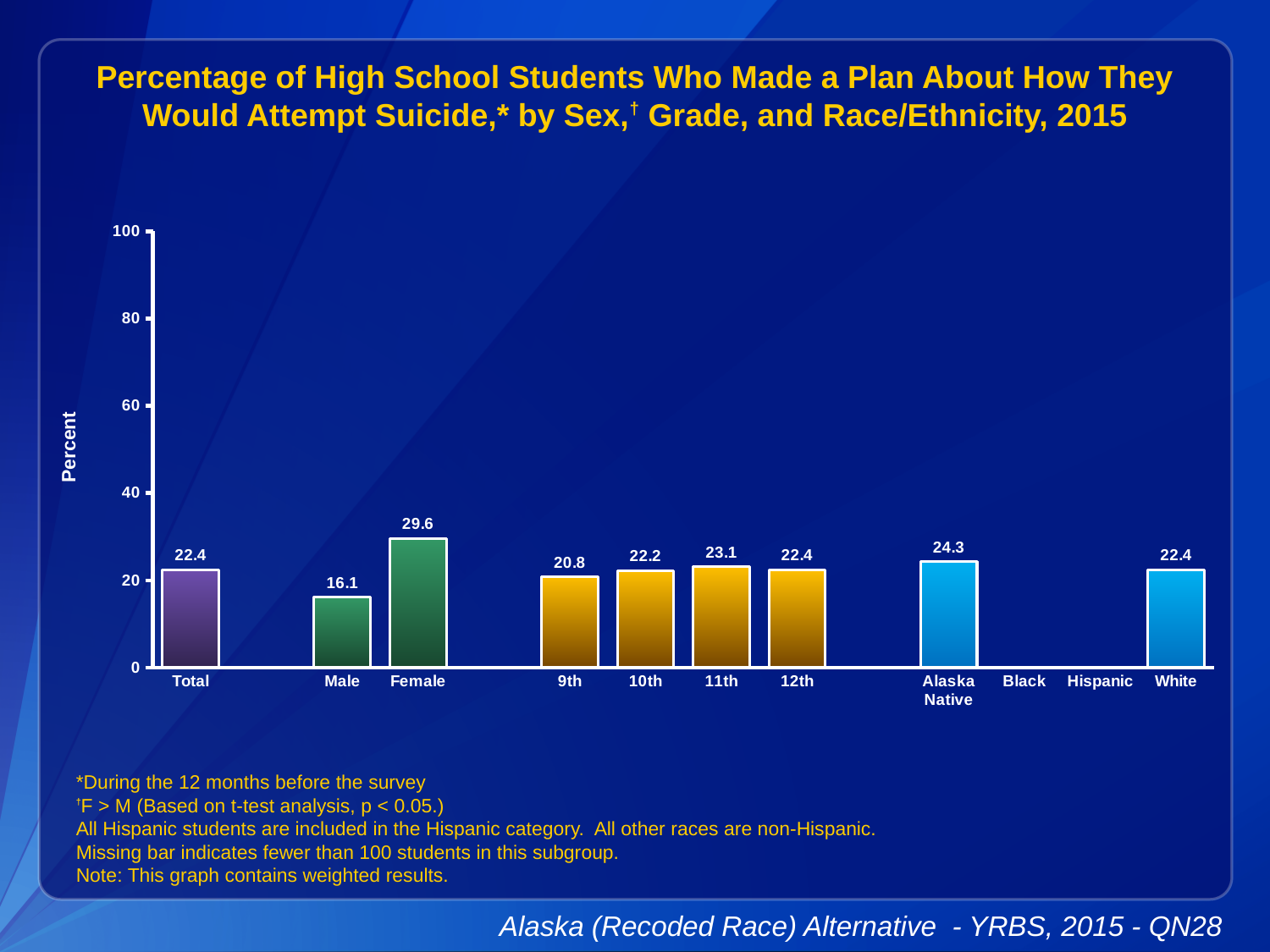
What is the value for Male? 16.1 What is the label of the y axis? Percent Is the value for Female greater or less than 40? less Which category has the highest value? Female Which is larger, the value for 11th grade or the value for 10th grade? 11th Which category has the lowest value among the plotted bars? Male What kind of chart is shown? bar chart How many bars are plotted on the chart? 9 What is the difference between the Female and Male values? 13.5 What is the value for Female? 29.6 What is the value for 9th grade? 20.8 What is the value for Alaska Native? 24.3